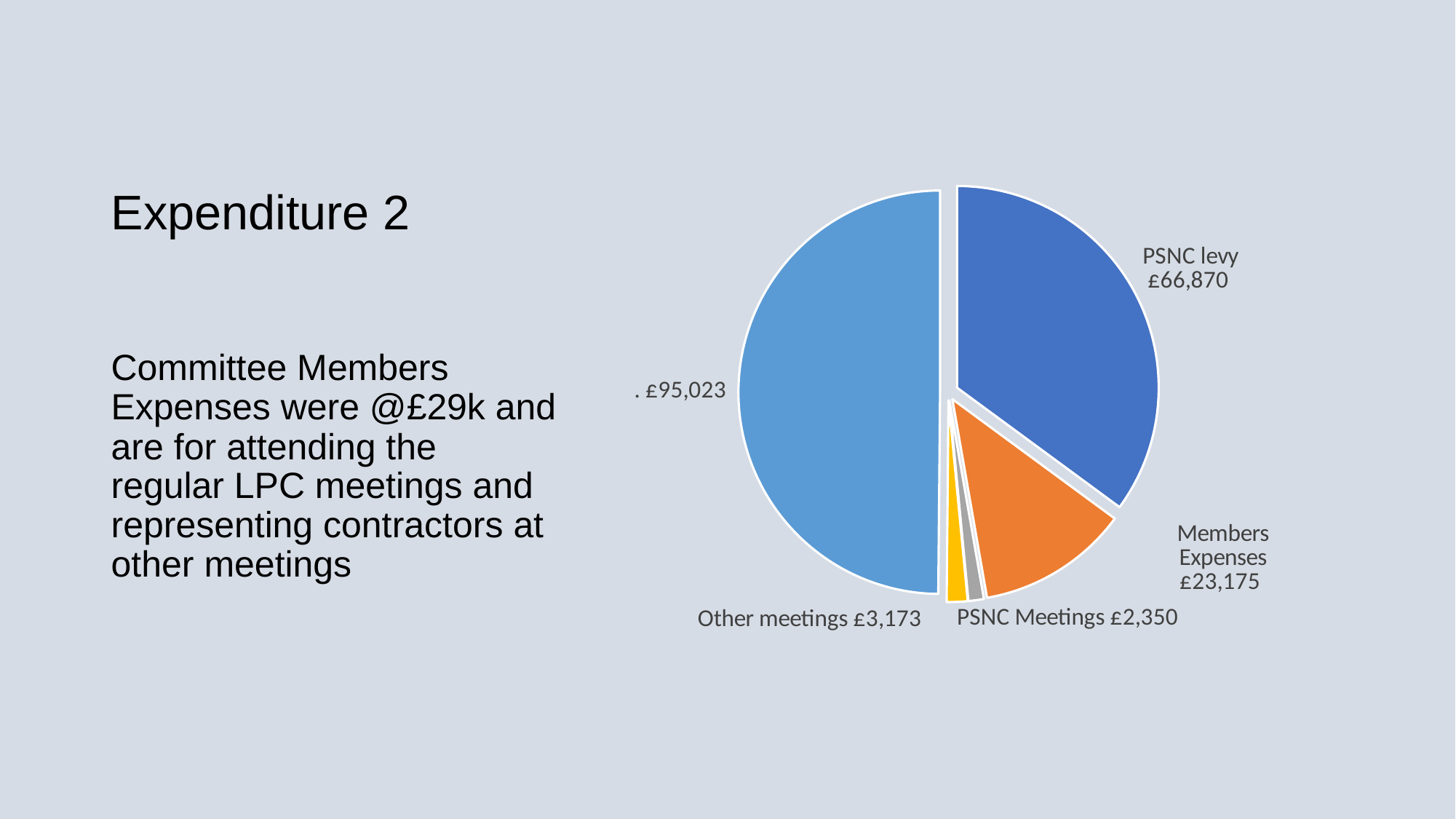
What is the value shown for Other meetings in the pie chart? £3,173 What kind of chart is shown on the slide? Pie chart Which is larger in the pie chart, PSNC levy or Members Expenses? PSNC levy How many slices does the pie chart have? 5 What is the value shown for Members Expenses in the pie chart? £23,175 What is the value shown for PSNC Meetings in the pie chart? £2,350 What is the value of the PSNC levy slice in the pie chart? £66,870 What is the value of the largest slice in the pie chart? £95,023 Which slice of the pie chart is the smallest? PSNC Meetings How much larger is the PSNC levy than Members Expenses in the pie chart? £43,695 What is the difference between Other meetings and PSNC Meetings in the pie chart? £823 What is the total of all the values shown in the pie chart? £190,591